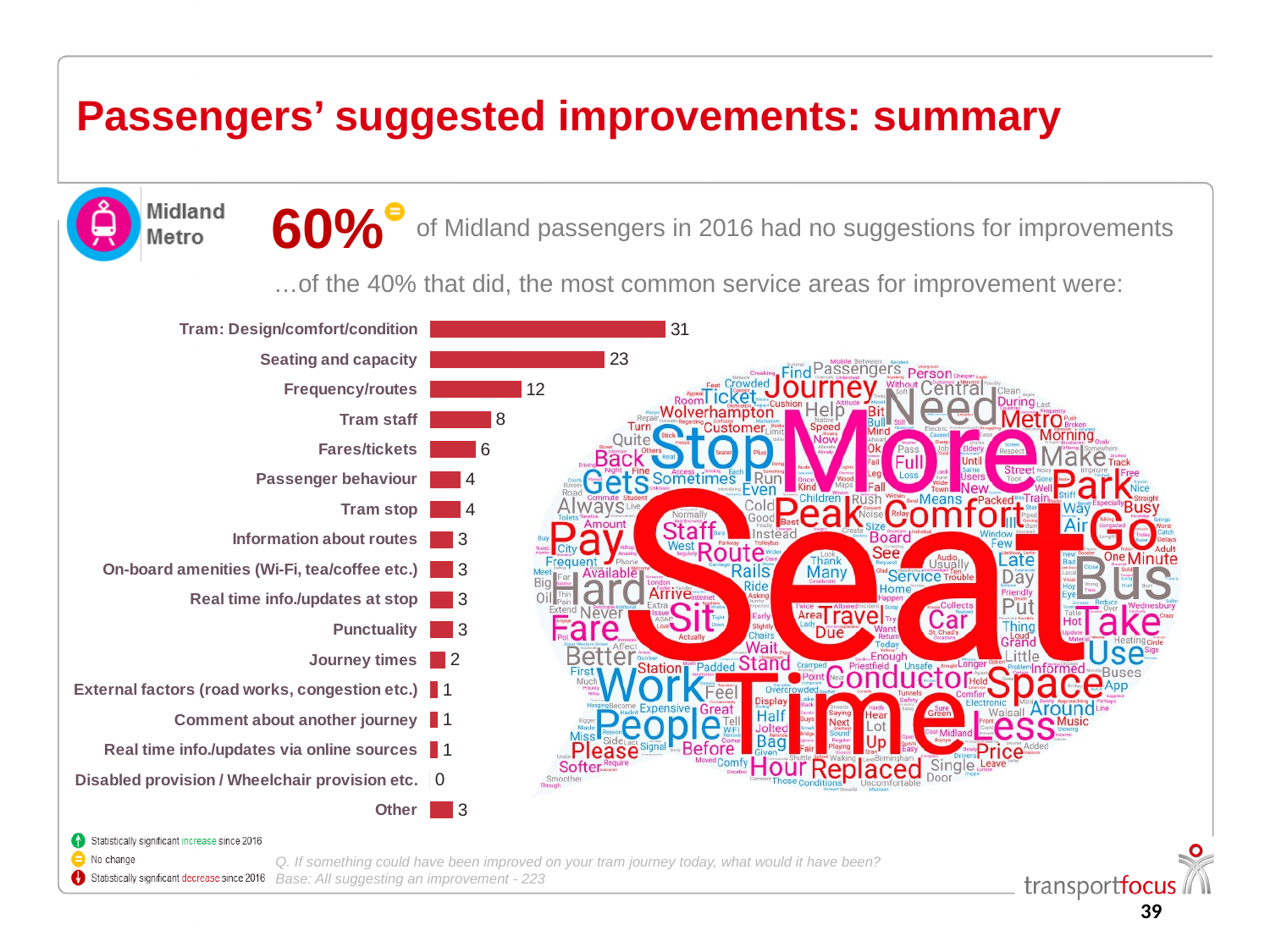
What is the value for Tram staff? 8 What is the difference between the values for Tram: Design/comfort/condition and Seating and capacity? 8 What kind of chart is shown on the slide? Bar chart Which category has the highest value in the bar chart? Tram: Design/comfort/condition How many categories are shown in the bar chart? 17 What is the value for Tram: Design/comfort/condition? 31 What is the value for Seating and capacity? 23 What is the value for Journey times? 2 What is the value for Frequency/routes? 12 What is the value for Other? 3 Which category has the lowest value in the bar chart? Disabled provision / Wheelchair provision etc. Which is larger, the value for Fares/tickets or the value for Passenger behaviour? Fares/tickets